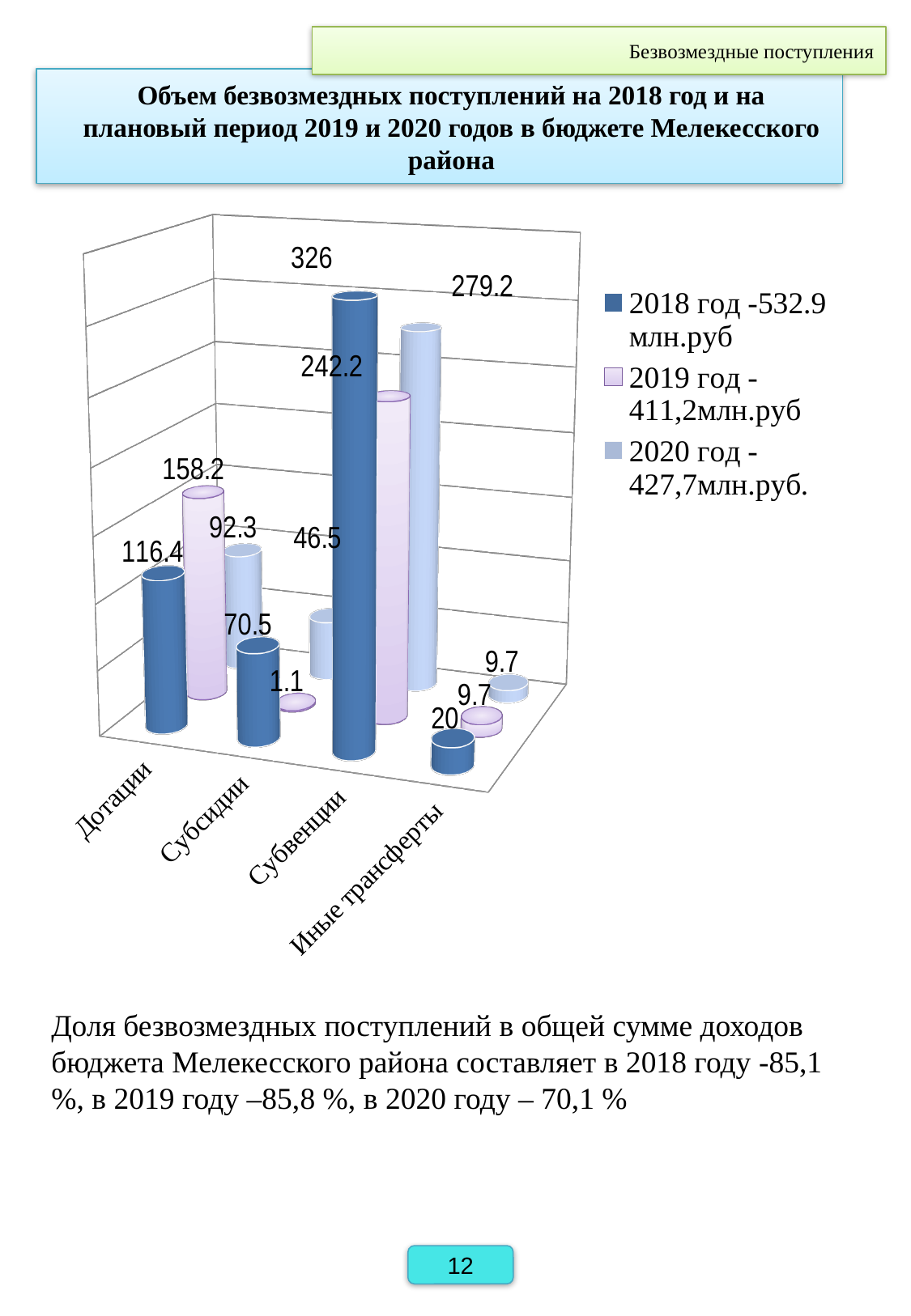
Which category has the highest value in the 2019 год series? Субвенции According to the legend, what is the total for the 2020 год series? 427,7млн.руб. How many series does the legend list? 3 What is the value for Субсидии in the 2020 год series? 46.5 Which is larger for Дотации: the 2018 год value or the 2019 год value? 2019 год What is the value for Иные трансферты in the 2018 год series? 20 How many categories are shown on the x axis? 4 What is the value for Субвенции in the 2018 год series? 326 Which category has the lowest value in the 2018 год series? Иные трансферты What kind of chart is shown on the slide? bar chart What is the value for Дотации in the 2019 год series? 158.2 What is the difference between the 2018 год and 2020 год values for Субвенции? 46.8